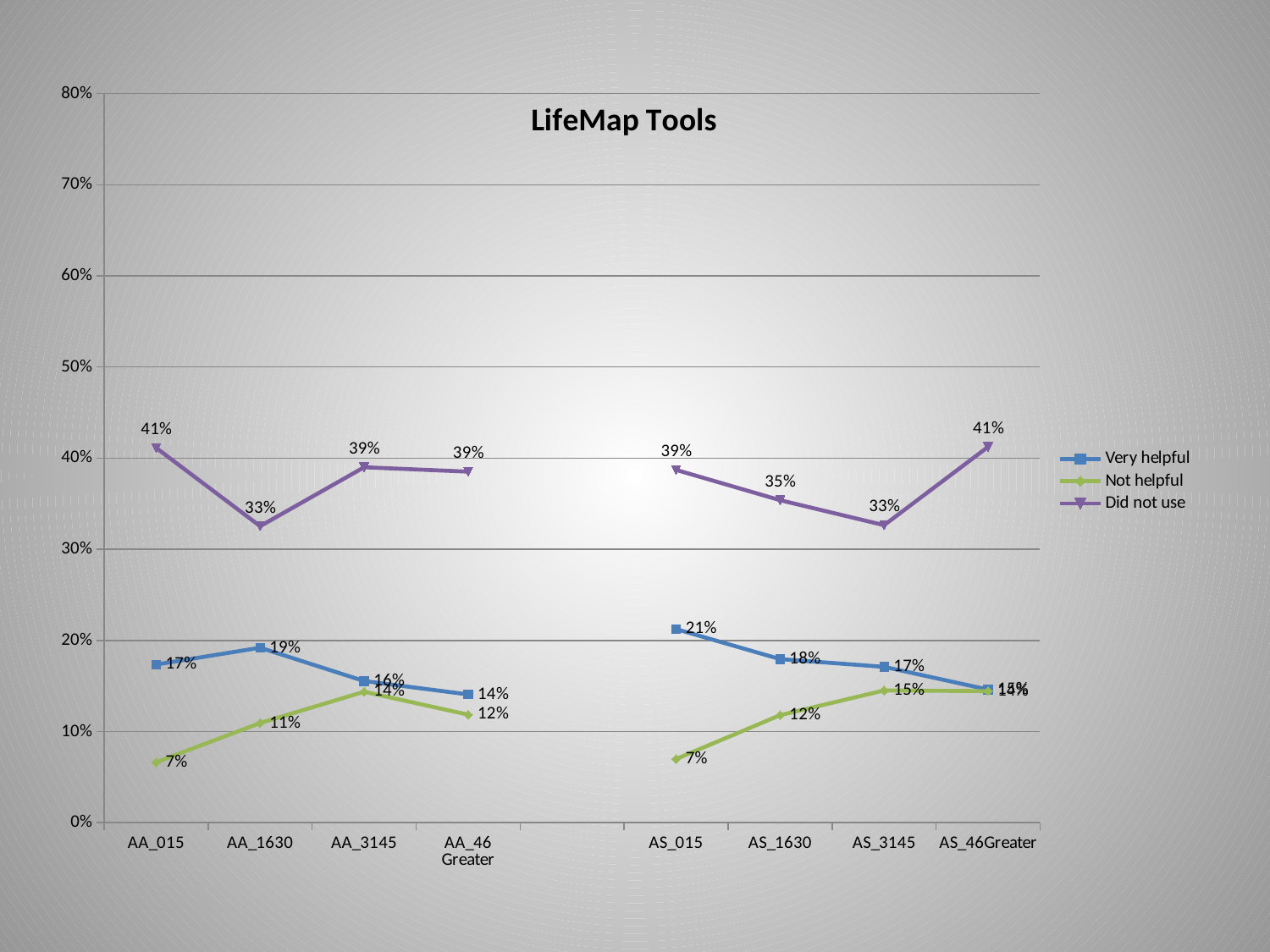
What kind of chart is shown on the slide? Line chart Which is larger, the 'Very helpful' value for AS_015 or for AA_015? AS_015 How many categories are shown on the x axis? 8 Which category has the highest 'Very helpful' value? AS_015 What is the 'Not helpful' value for AA_1630? 11% What is the difference between the 'Did not use' values for AA_015 and AA_1630? 8 percentage points What is the 'Did not use' value for AA_015? 41% What is the title of the chart? LifeMap Tools Does the 'Very helpful' series rise or fall from AS_015 to AS_3145? Fall What is the 'Did not use' value for AS_1630? 35% How many series does the legend list? 3 What is the 'Very helpful' value for AS_015? 21%